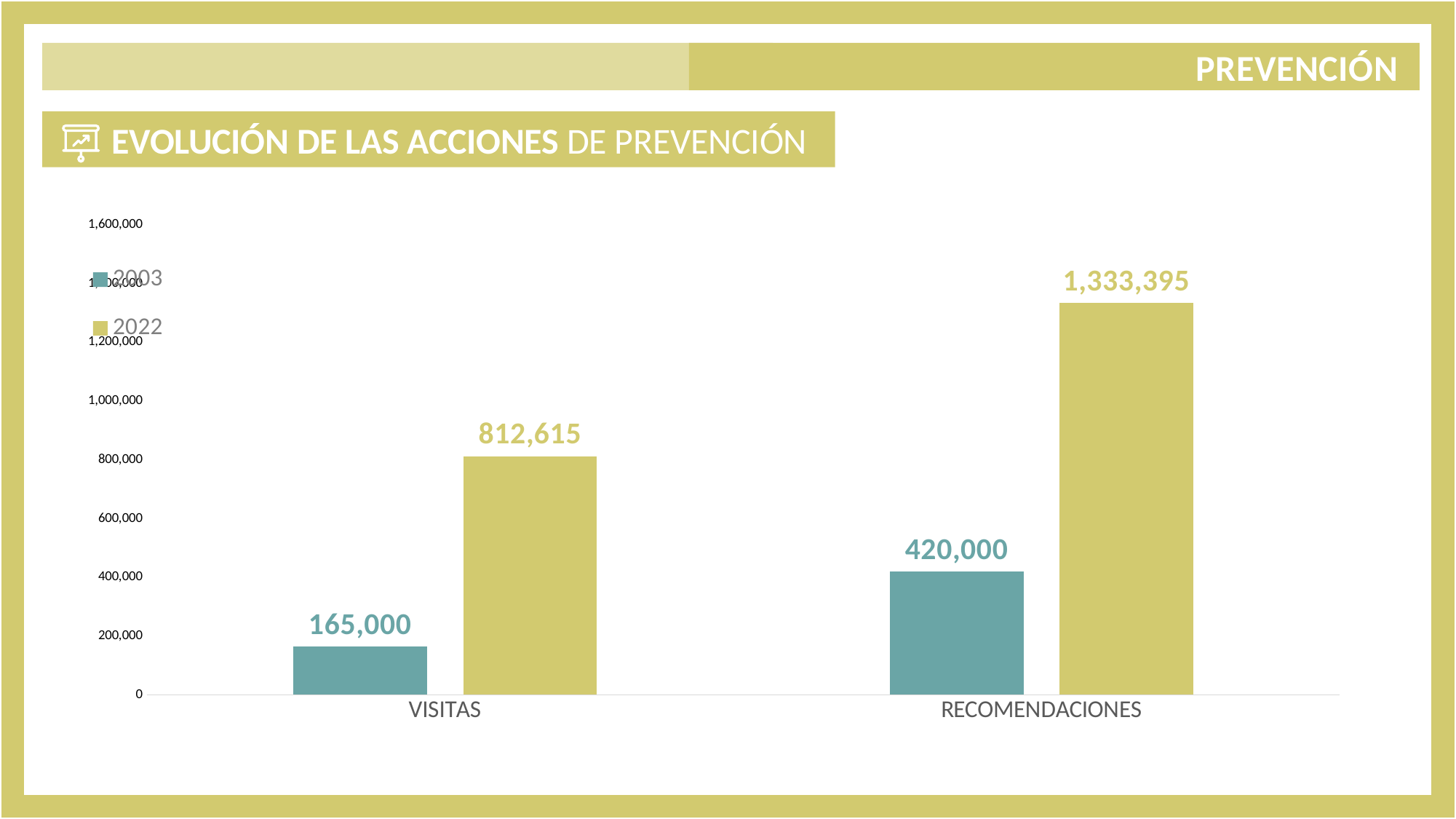
How many categories are shown on the x axis? 2 Which is larger: VISITAS in 2022 or RECOMENDACIONES in 2003? VISITAS in 2022 What is the difference between the 2022 and 2003 values for RECOMENDACIONES? 913,395 What is the value for RECOMENDACIONES in 2022? 1,333,395 What kind of chart is shown on the slide? Bar chart Which bar has the highest value on the chart? RECOMENDACIONES in 2022 How many series does the legend list? 2 What is the difference between the 2022 and 2003 values for VISITAS? 647,615 What is the value for VISITAS in 2022? 812,615 What is the value for RECOMENDACIONES in 2003? 420,000 What is the value for VISITAS in 2003? 165,000 Which bar has the lowest value on the chart? VISITAS in 2003